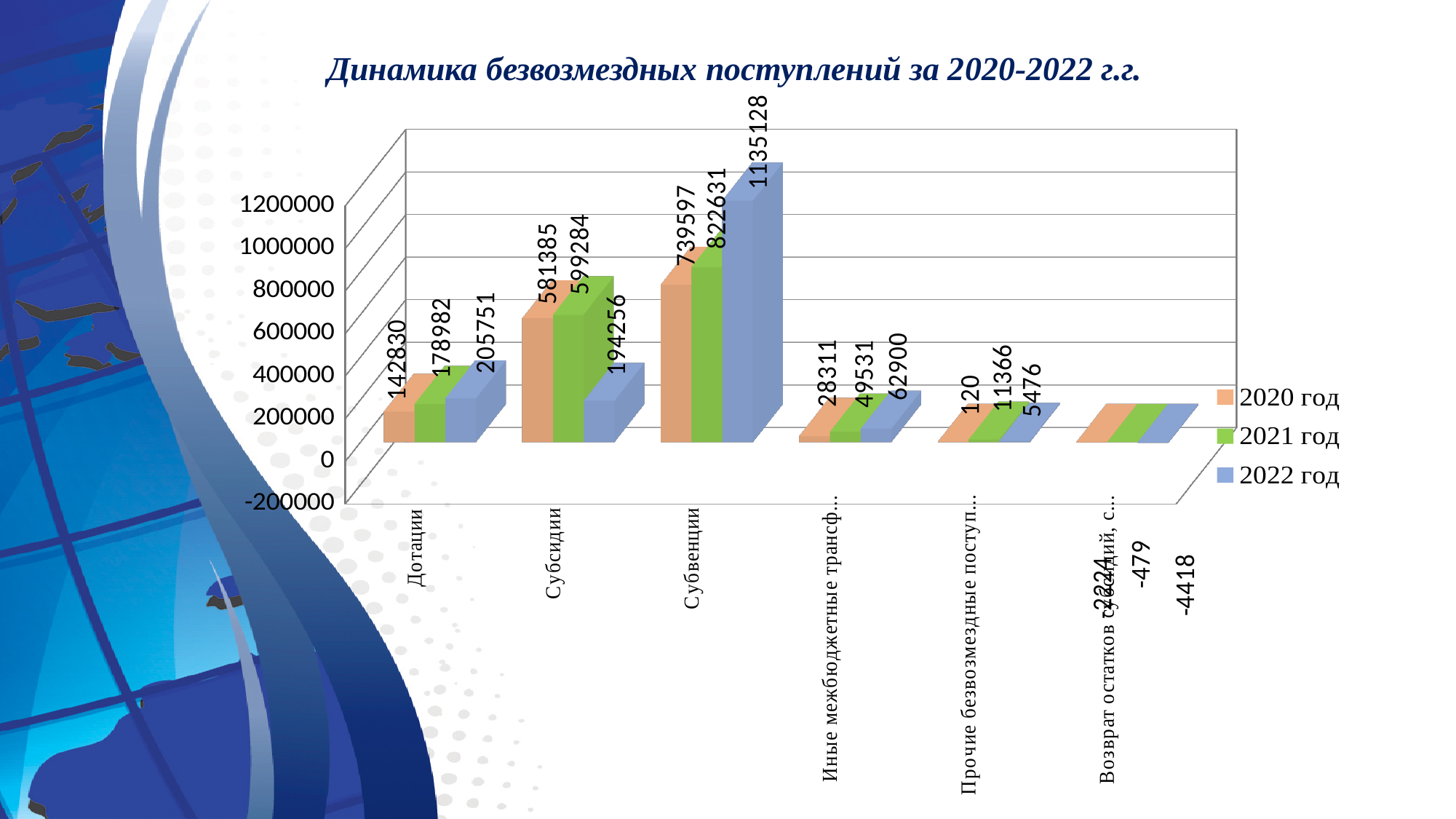
What is the title of the chart? Динамика безвозмездных поступлений за 2020-2022 г.г. How many categories are shown on the x axis? 6 Do the values for Дотации rise or fall from 2020 год to 2022 год? rise For Субсидии, which is larger: the 2020 год value or the 2022 год value? 2020 год What is the difference between the 2022 год and 2020 год values for Дотации? 62921 What is the value for Субсидии in 2021 год? 599284 What is the difference between the 2022 год and 2021 год values for Субвенции? 312497 What is the value for Дотации in 2020 год? 142830 What kind of chart is shown on the slide? bar chart Which category has the highest value for 2022 год? Субвенции What is the value for Субвенции in 2022 год? 1135128 How many series does the legend list? 3